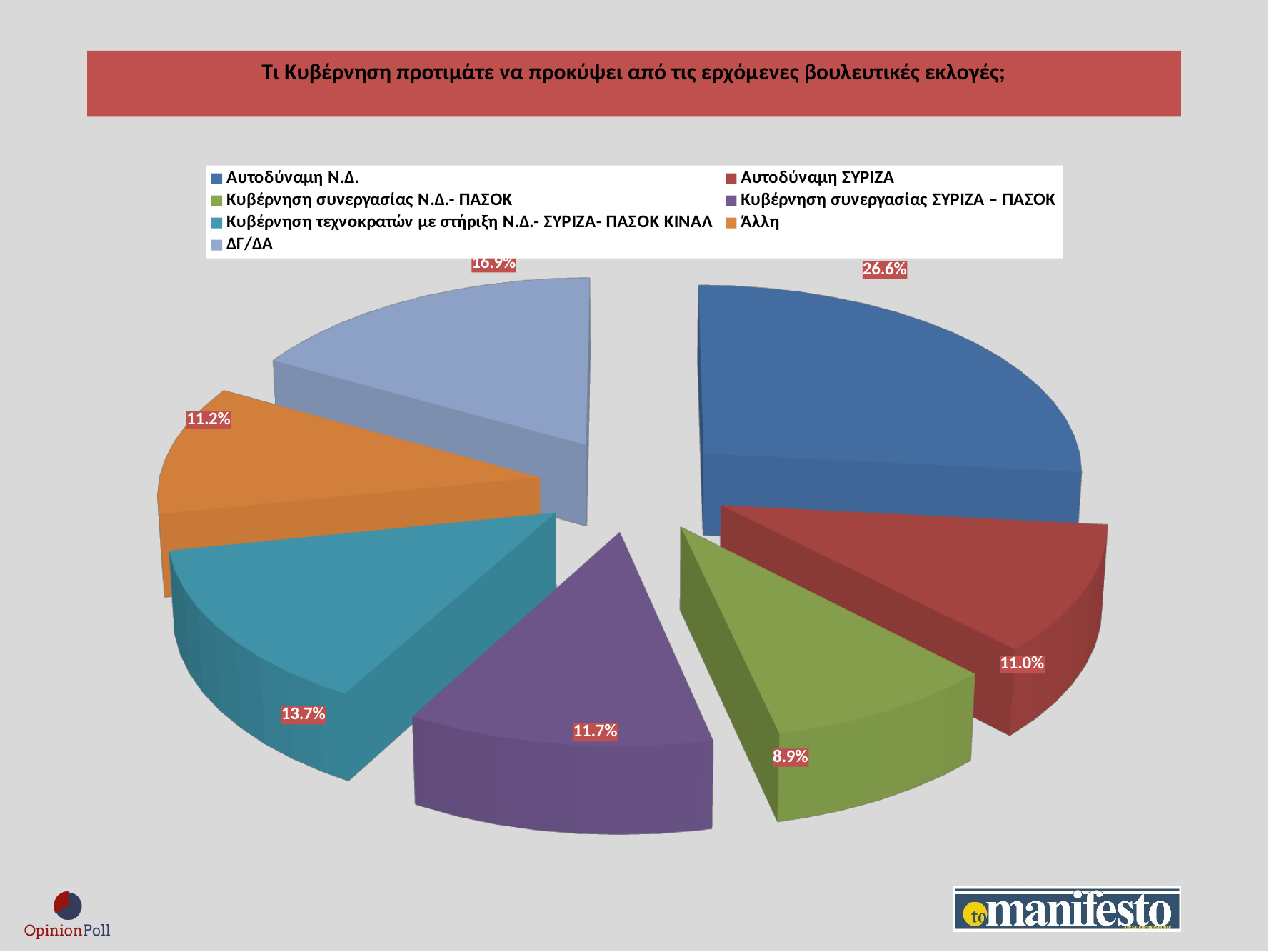
What percentage is shown for ΔΓ/ΔΑ? 16.9% What percentage is shown for Αυτοδύναμη Ν.Δ.? 26.6% Which category has the largest share of the pie? Αυτοδύναμη Ν.Δ. What percentage is shown for Κυβέρνηση συνεργασίας Ν.Δ.- ΠΑΣΟΚ? 8.9% What percentage is shown for Κυβέρνηση συνεργασίας ΣΥΡΙΖΑ – ΠΑΣΟΚ? 11.7% Which category has the smallest share of the pie? Κυβέρνηση συνεργασίας Ν.Δ.- ΠΑΣΟΚ What percentage is shown for Κυβέρνηση τεχνοκρατών με στήριξη Ν.Δ.- ΣΥΡΙΖΑ- ΠΑΣΟΚ ΚΙΝΑΛ? 13.7% How many categories does the pie chart have? 7 Which is larger: the share for Άλλη or the share for Κυβέρνηση συνεργασίας ΣΥΡΙΖΑ – ΠΑΣΟΚ? Κυβέρνηση συνεργασίας ΣΥΡΙΖΑ – ΠΑΣΟΚ What is the difference in percentage points between Αυτοδύναμη Ν.Δ. and Αυτοδύναμη ΣΥΡΙΖΑ? 15.6 What percentage is shown for Αυτοδύναμη ΣΥΡΙΖΑ? 11.0% What kind of chart is shown on the slide? pie chart